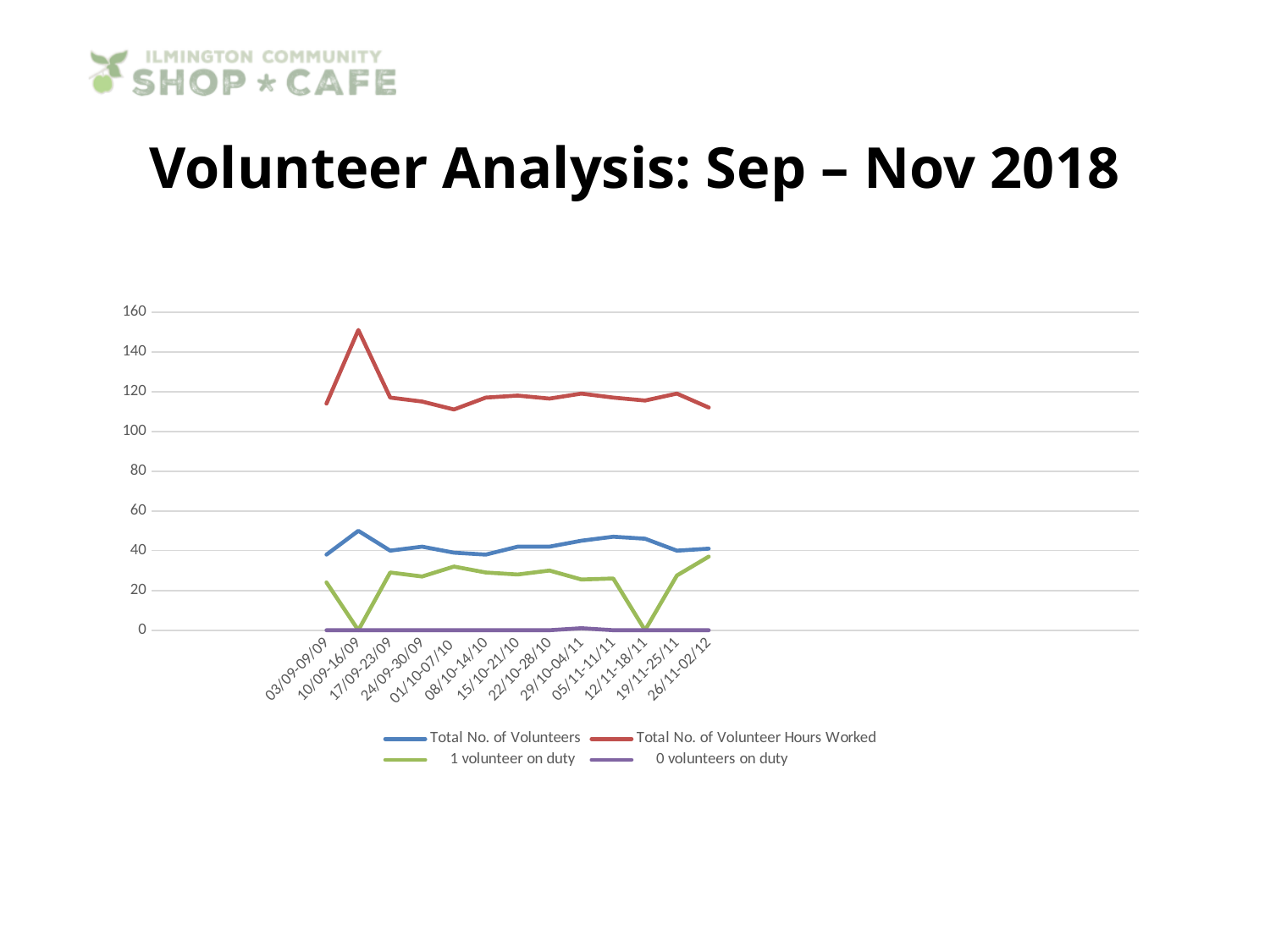
In which week is Total No. of Volunteer Hours Worked highest? 10/09-16/09 Does Total No. of Volunteer Hours Worked rise or fall from 10/09-16/09 to 17/09-23/09? fall Which series is drawn in red? Total No. of Volunteer Hours Worked Is the value for Total No. of Volunteers in 10/09-16/09 greater or less than 40? greater What kind of chart is shown on the slide? line chart How many weekly periods are shown on the x axis? 13 What is the title of the slide containing the chart? Volunteer Analysis: Sep – Nov 2018 How many series does the legend list? 4 Is the value for 1 volunteer on duty in 03/09-09/09 greater or less than 20? greater Is the value for Total No. of Volunteer Hours Worked in 10/09-16/09 greater or less than 140? greater Which is larger in 03/09-09/09: Total No. of Volunteers or 1 volunteer on duty? Total No. of Volunteers